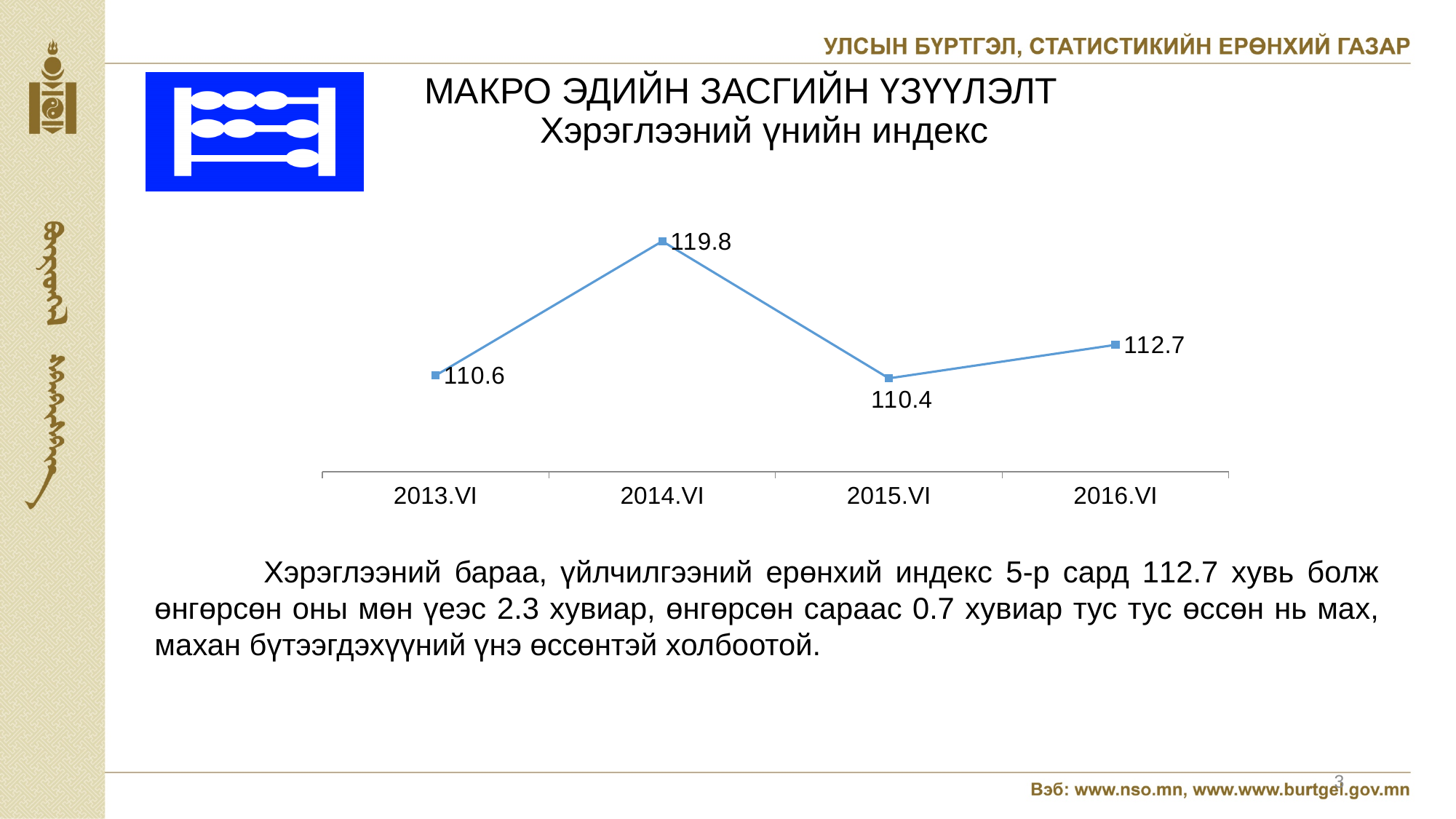
Which period has the lowest value? 2015.VI What is the difference between the values for 2016.VI and 2013.VI? 2.1 Which period has the highest value? 2014.VI What is the value for 2013.VI? 110.6 Does the value rise or fall from 2014.VI to 2015.VI? fall What is the value for 2014.VI? 119.8 What is the value for 2016.VI? 112.7 What is the difference between the values for 2014.VI and 2015.VI? 9.4 What kind of chart is shown on the slide? line chart Which is larger, the value for 2016.VI or the value for 2013.VI? 2016.VI How many periods are plotted on the chart? 4 What is the value for 2015.VI? 110.4